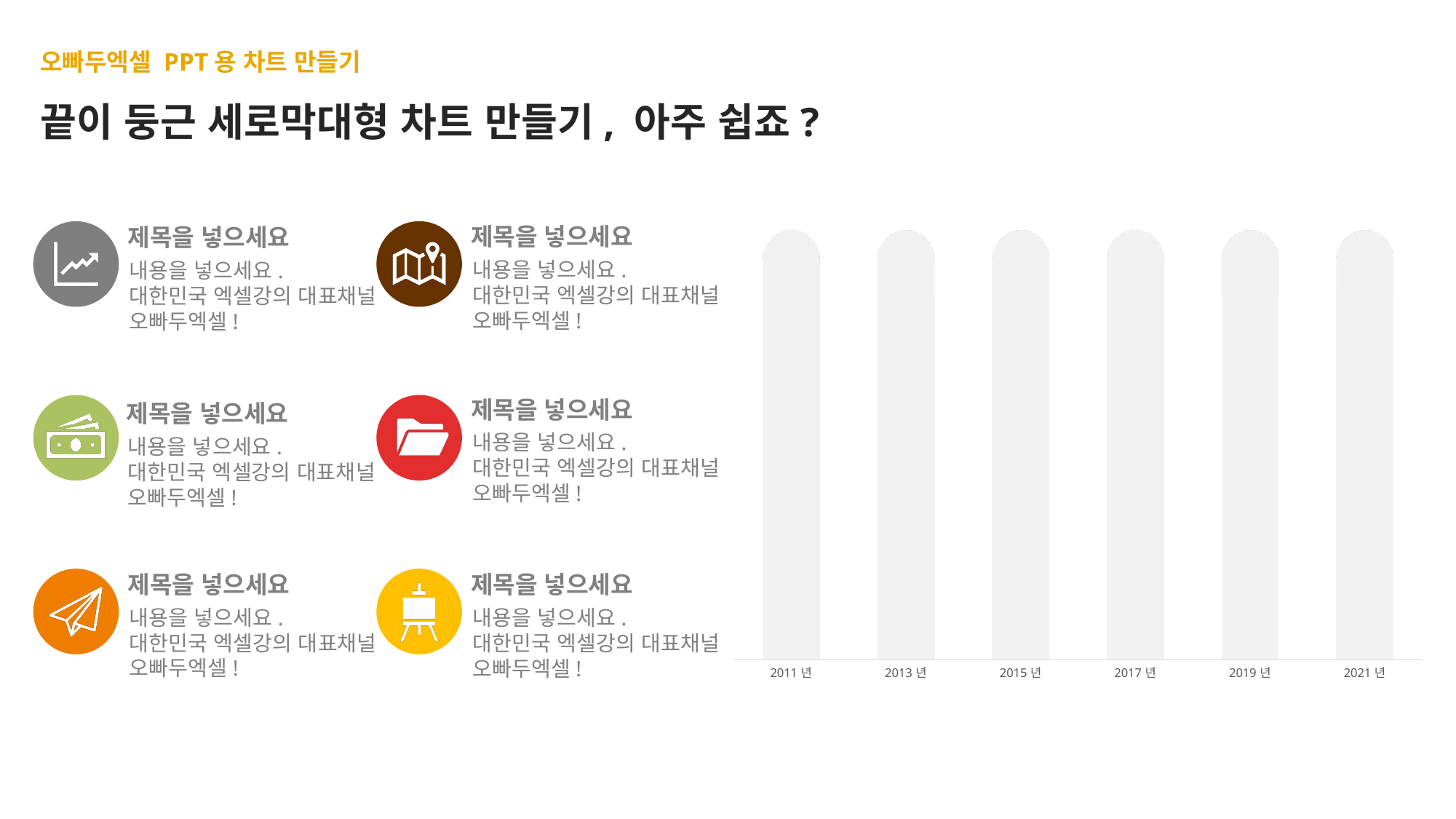
How many bars (categories) does the chart on the right show? 6 What kind of chart is shown on the right side of the slide? bar chart Do the bar heights rise, fall, or stay the same from 2011 년 to 2021 년? stay the same What is the label of the last category on the x axis of the chart? 2021 년 What is the label of the first category on the x axis of the chart? 2011 년 Is the bar for 2013 년 taller, shorter, or the same height as the bar for 2019 년? the same height